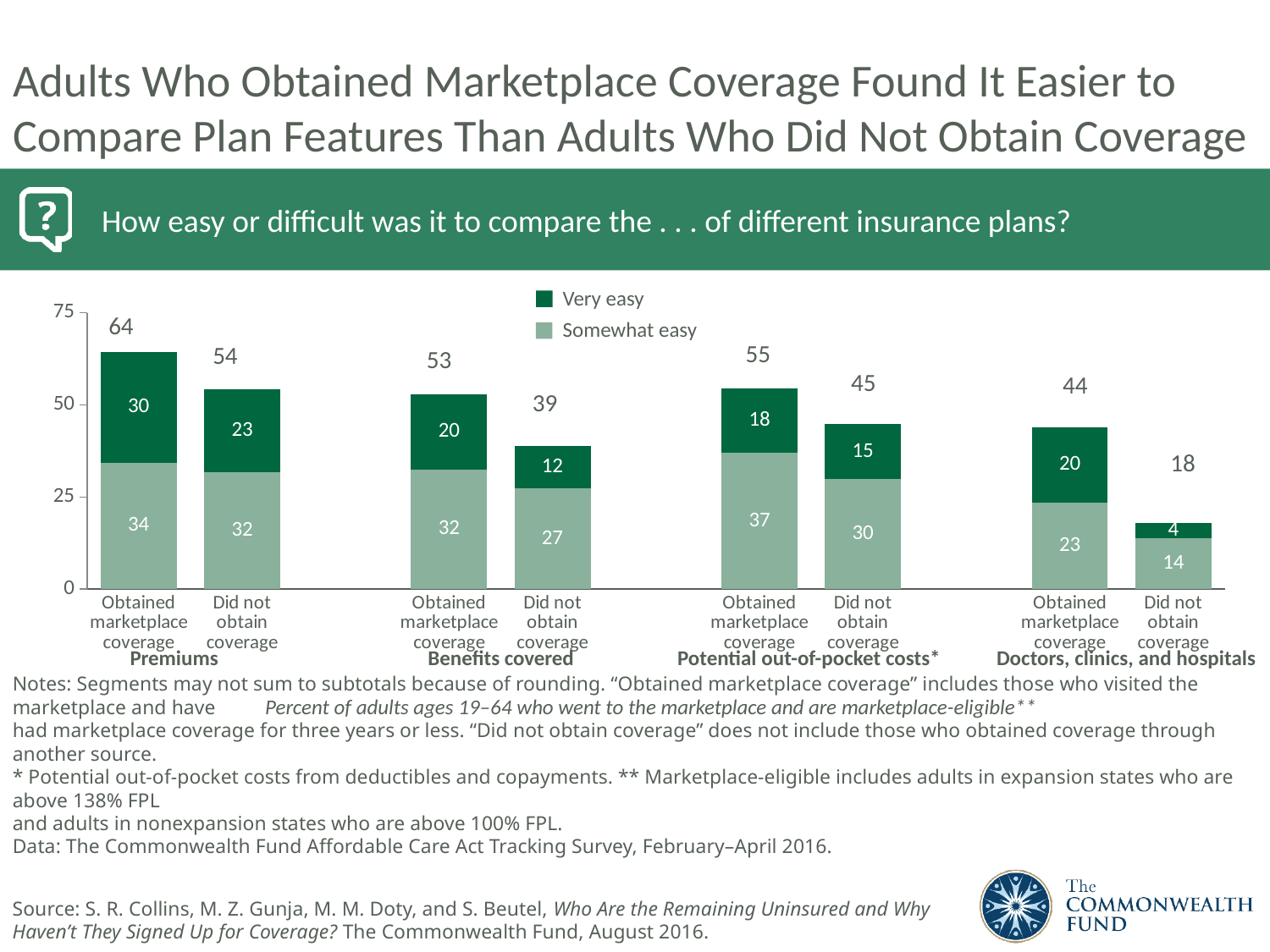
What type of chart is shown on the slide? Stacked bar chart How many series does the legend list? 2 Which bar has the highest total value? Obtained marketplace coverage, Premiums Which bar has the lowest total value? Did not obtain coverage, Doctors, clinics, and hospitals What is the difference between the totals for obtained marketplace coverage and did not obtain coverage in the Doctors, clinics, and hospitals group? 26 In the Benefits covered group, which is larger: the total for obtained marketplace coverage or for did not obtain coverage? Obtained marketplace coverage What is the 'Very easy' value for adults who did not obtain coverage in the Potential out-of-pocket costs group? 15 What is the 'Somewhat easy' value for adults who obtained marketplace coverage in the Potential out-of-pocket costs group? 37 How many bars are plotted in the chart? 8 What is the 'Very easy' value for adults who did not obtain coverage in the Benefits covered group? 12 Which legend entry is shown in the darker green colour? Very easy What is the total percentage for adults who obtained marketplace coverage in the Premiums group? 64